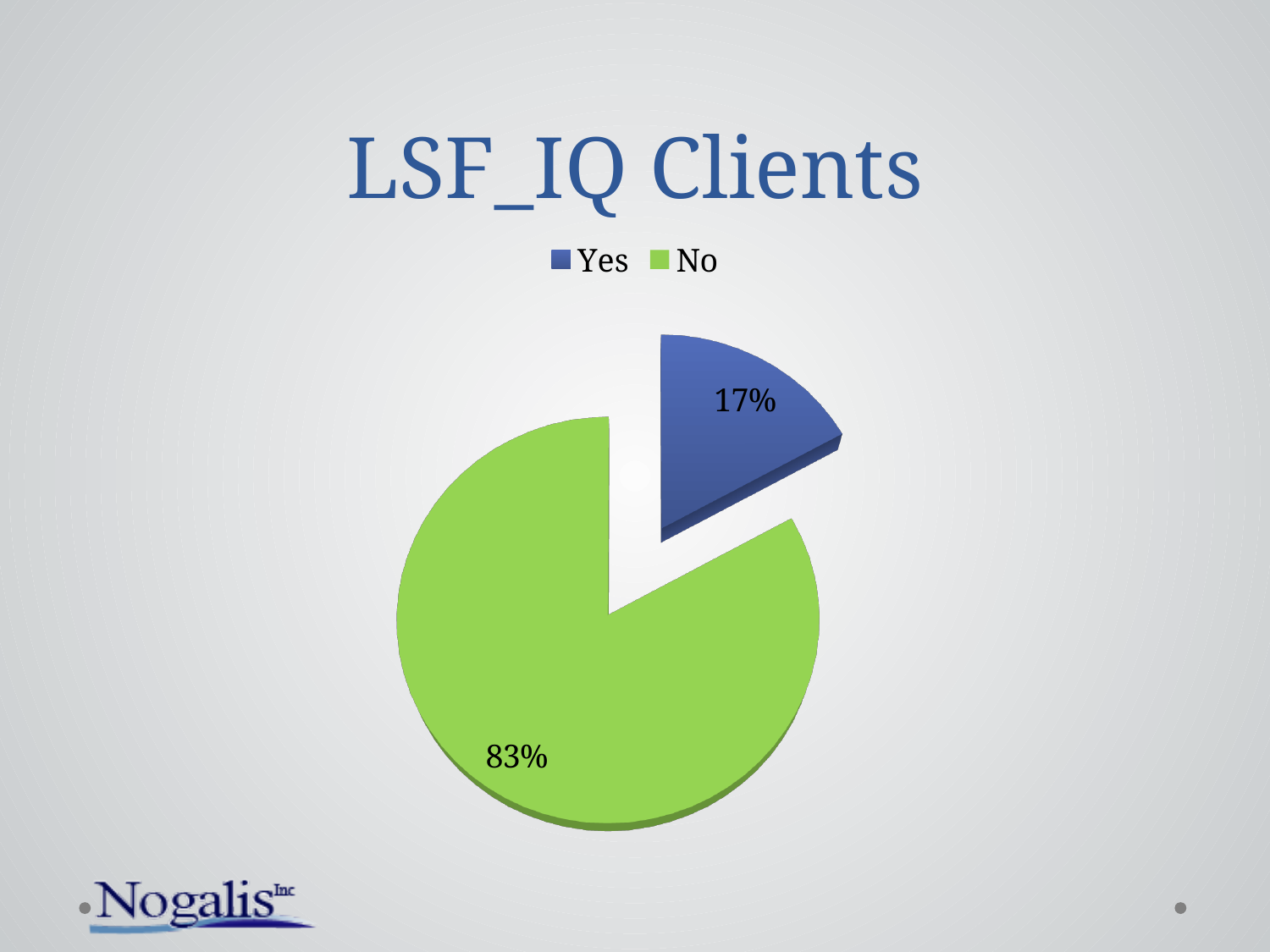
What percentage of the pie is labelled "Yes"? 17% Which slice is the smallest? Yes What is the title of the chart? LSF_IQ Clients What kind of chart is shown on the slide? Pie chart What share of the pie does the "No" slice represent? 83% Which is larger, the "Yes" slice or the "No" slice? No What colour is the "Yes" slice? Blue Which slice is the largest? No What is the difference in percentage points between the "No" slice and the "Yes" slice? 66 What percentage of the pie is labelled "No"? 83% How many entries does the legend list? 2 How many slices does the pie chart have? 2